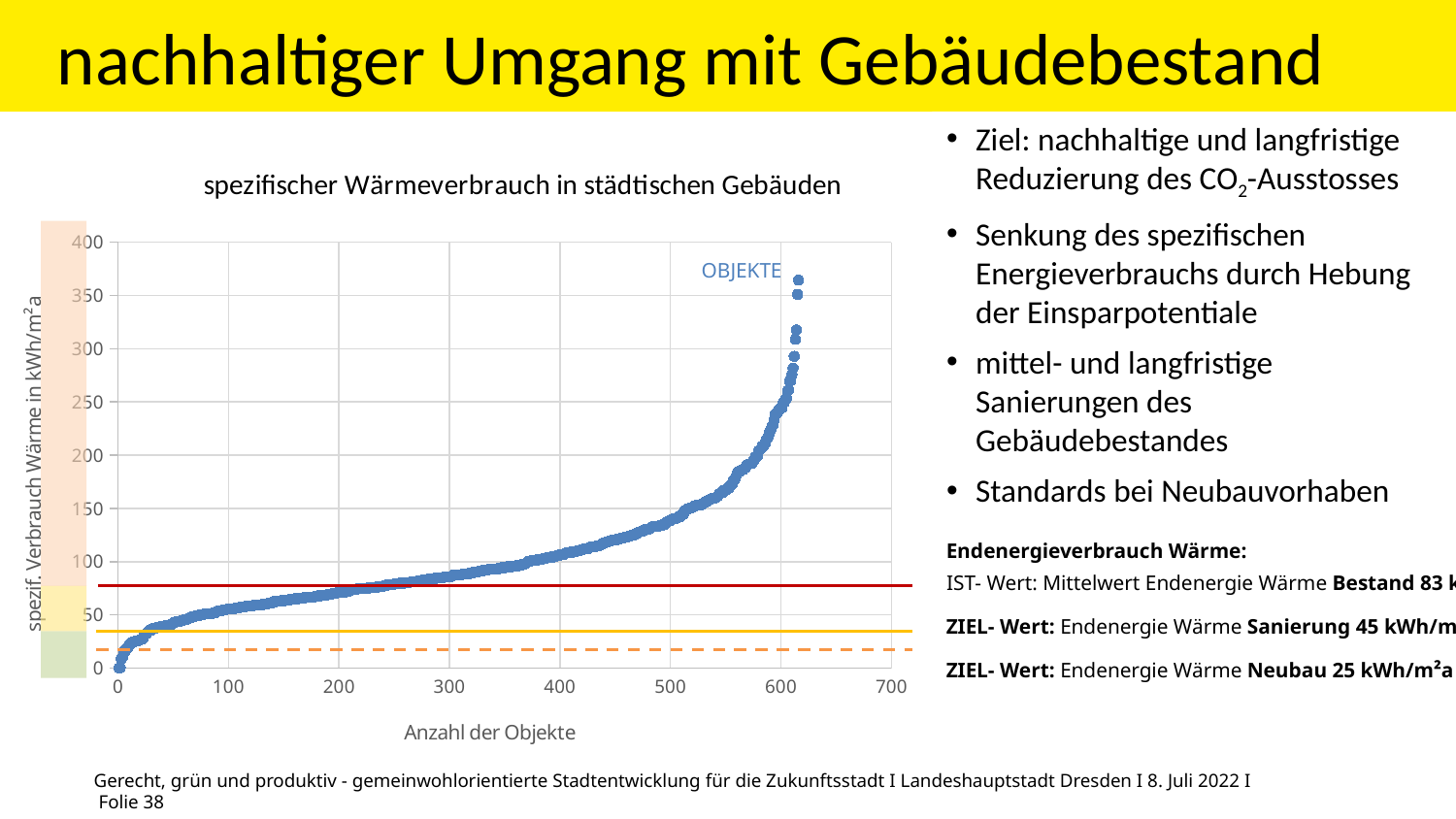
Do the plotted values rise or fall as the number of objects increases along the x axis? rise Is the plotted value at 500 objects greater or less than 100? greater Is the plotted value at 300 objects greater or less than 100? less Is the plotted value at 100 objects greater or less than 100? less How many series does the chart legend list? 1 What is the label of the x axis of the chart? Anzahl der Objekte What is the title of the chart? spezifischer Wärmeverbrauch in städtischen Gebäuden What kind of chart is shown on the slide? scatter chart What is the name of the series shown in the chart legend? OBJEKTE What is the highest tick value shown on the y axis of the chart? 400 What is the highest tick value shown on the x axis of the chart? 700